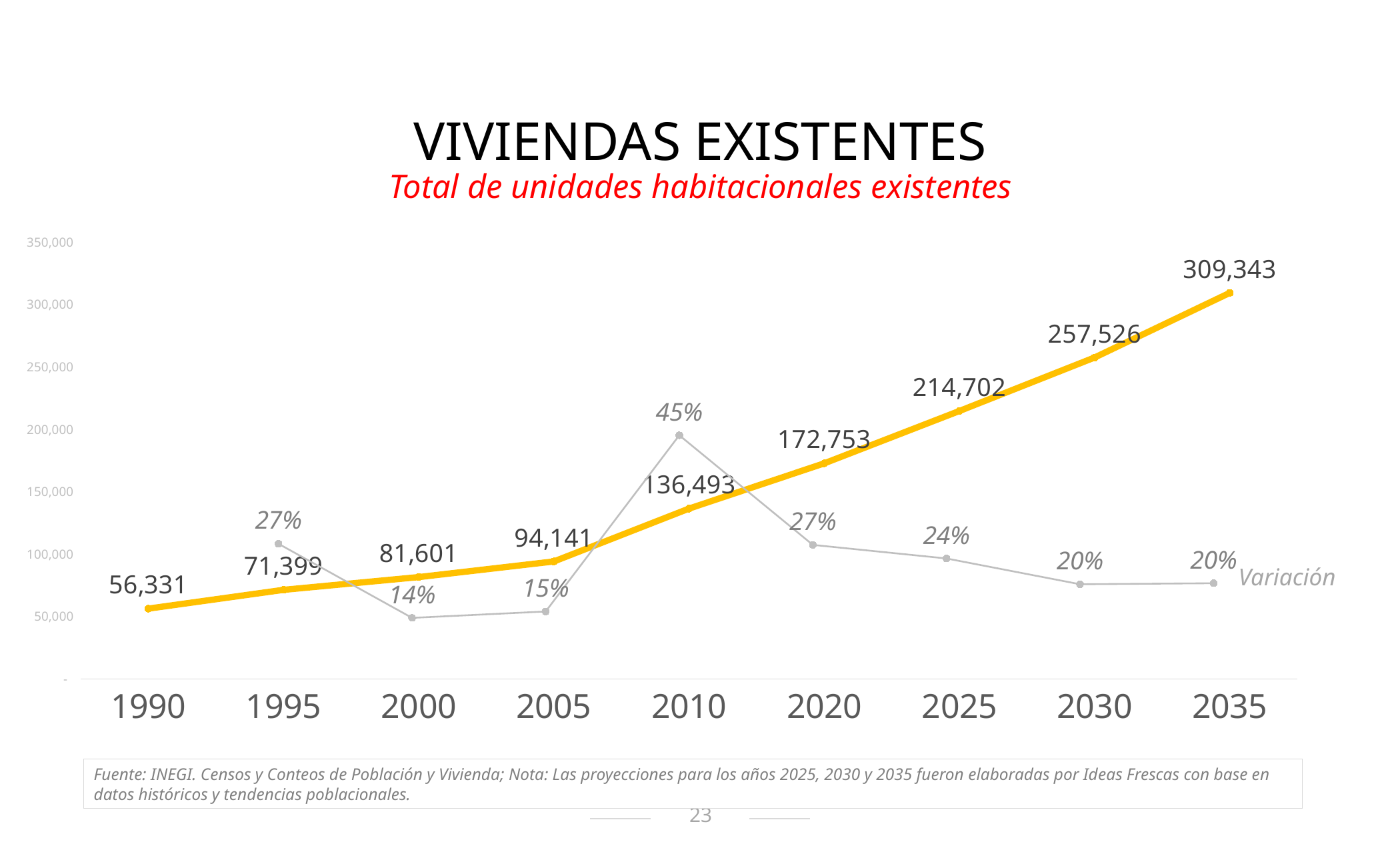
What is the difference between the values for 2035 and 2030? 51,817 What value is shown for 2035? 309,343 Do the existing housing unit values rise or fall from 1990 to 2035? Rise What is the total of existing housing units shown for 2010? 136,493 How many years are shown on the x axis? 9 What is the Variación percentage shown for 2010? 45% Which is larger, the value for 2020 or the value for 2025? 2025 What is the title of the chart? VIVIENDAS EXISTENTES Which year has the highest number of existing housing units? 2035 What kind of chart is shown on the slide? Line chart What is the Variación percentage shown for 2000? 14% Which year has the lowest number of existing housing units? 1990